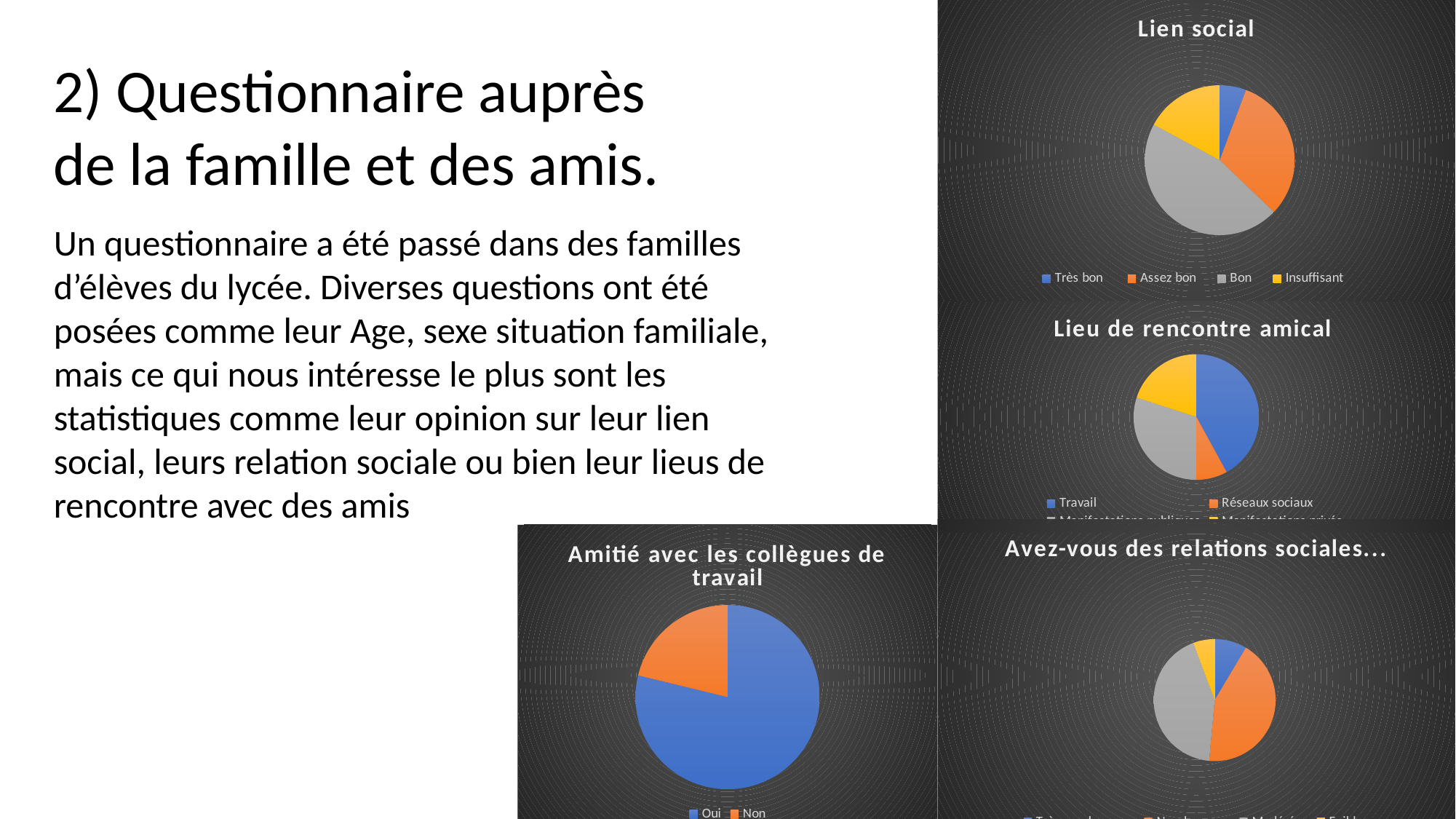
In the "Amitié avec les collègues de travail" chart, which slice is larger, Oui or Non? Oui In the "Lien social" chart, which category has the largest slice? Bon What colour is the "Oui" slice in the "Amitié avec les collègues de travail" chart? blue In the "Lieu de rencontre amical" chart, which category has the smallest slice? Réseaux sociaux In the "Lieu de rencontre amical" chart, which slice is larger, Travail or Réseaux sociaux? Travail In the "Lien social" chart, which slice is larger, Assez bon or Insuffisant? Assez bon In the "Lien social" chart, which category has the smallest slice? Très bon How many pie charts are shown on the slide? 4 How many categories does the legend of the "Lien social" chart list? 4 How many categories does the legend of the "Amitié avec les collègues de travail" chart list? 2 What kind of chart is the "Lien social" chart? pie chart In the "Lieu de rencontre amical" chart, which category has the largest slice? Travail